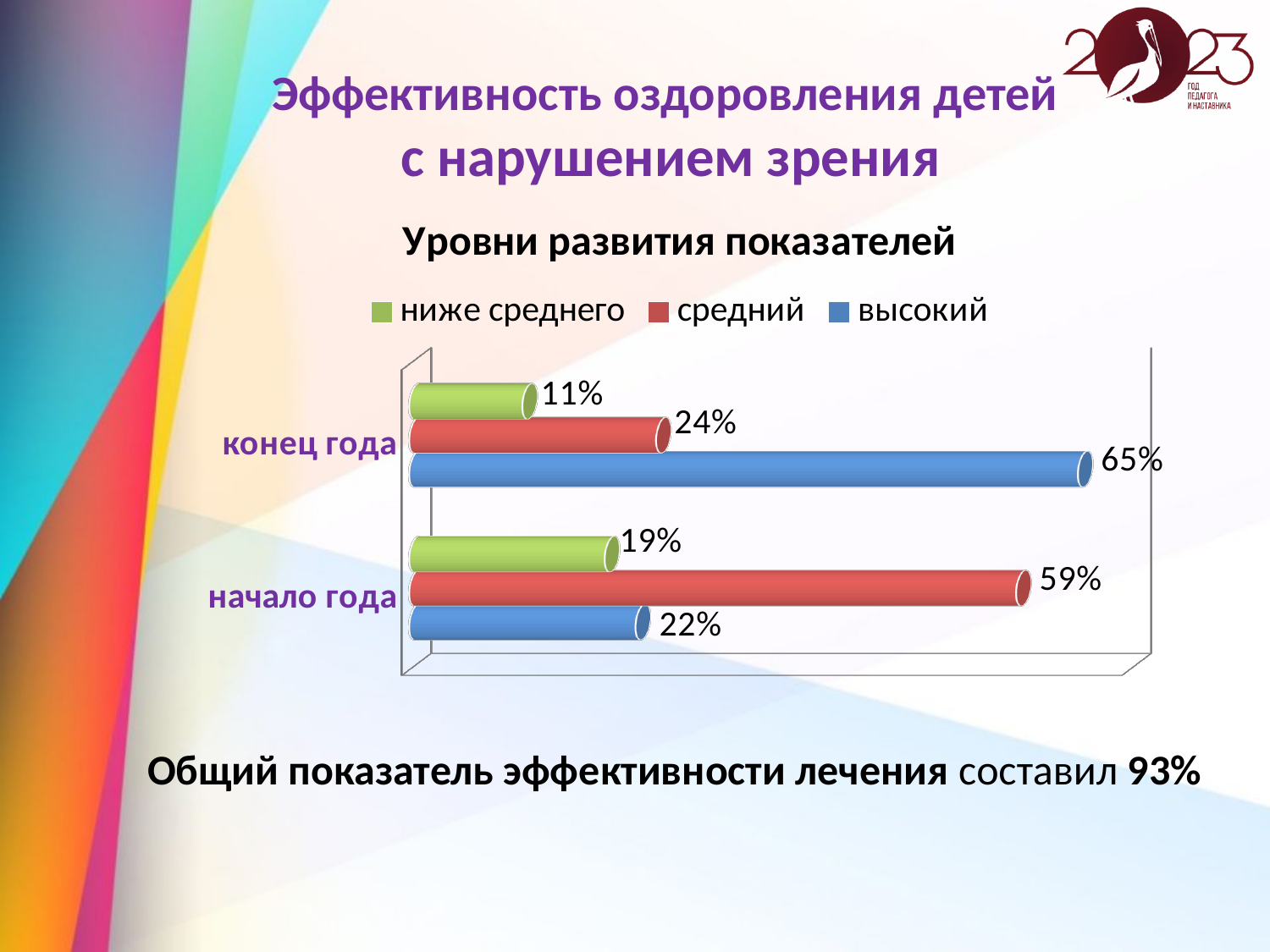
What is the value for "средний" at "начало года"? 59% Which is larger: "ниже среднего" at "начало года" or "ниже среднего" at "конец года"? начало года What is the value for "высокий" at "конец года"? 65% Which series has the highest value at "начало года"? средний What is the value for "ниже среднего" at "конец года"? 11% What is the difference between the "высокий" values at "конец года" and "начало года"? 43% What kind of chart is shown on the slide? bar chart What is the title of the chart? Уровни развития показателей Which series has the lowest value at "конец года"? ниже среднего What is the value for "высокий" at "начало года"? 22% How many categories are shown on the chart? 2 How many series does the legend list? 3